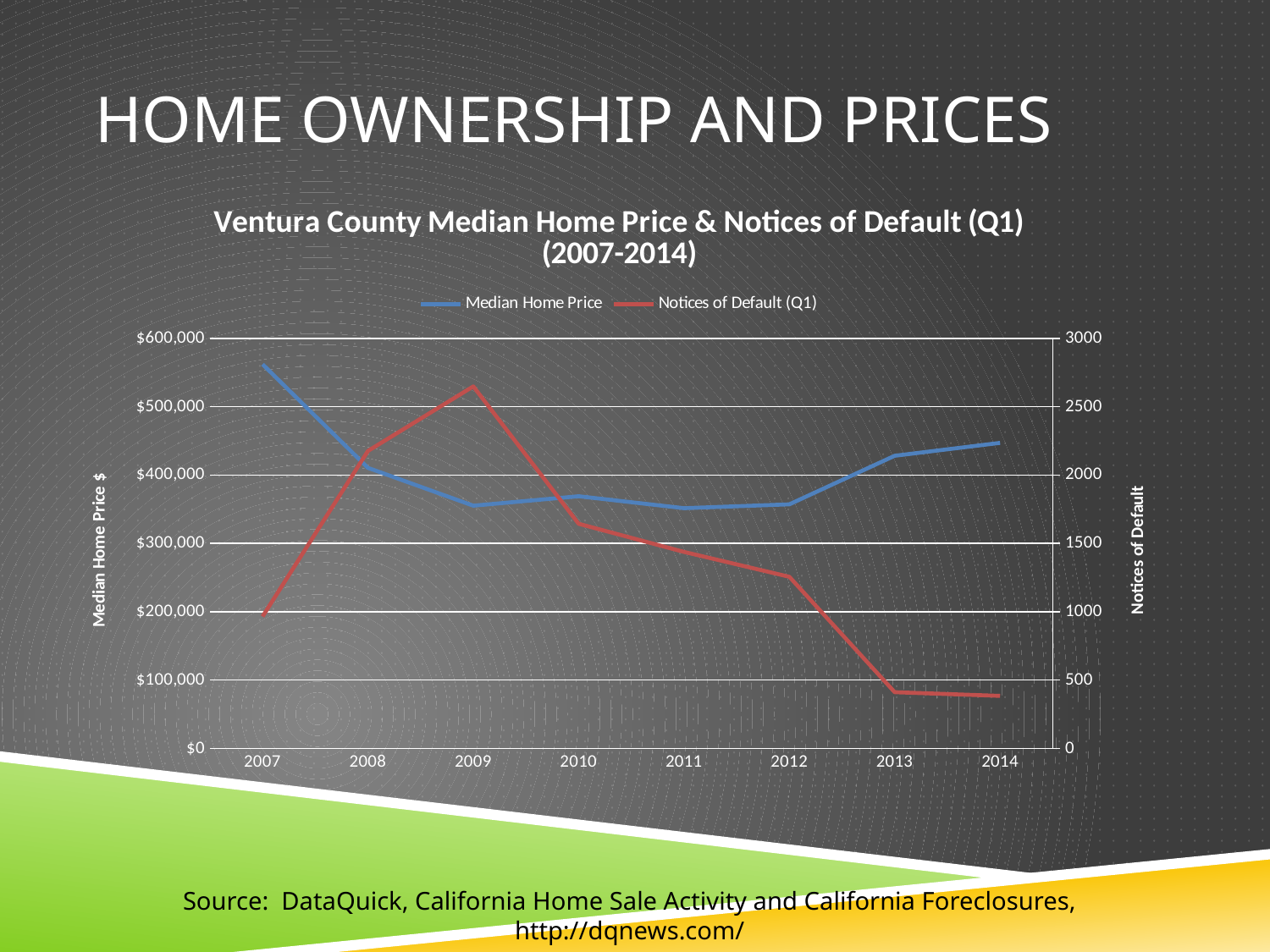
Is the Median Home Price for 2007 greater or less than $500,000? greater Is the value for Notices of Default (Q1) in 2013 greater or less than 500? less Do the Notices of Default (Q1) rise or fall from 2009 to 2014? Fall In which year is the Median Home Price highest? 2007 Which is larger, the Median Home Price in 2007 or in 2014? 2007 How many series does the legend list? 2 How many years are plotted along the x axis? 8 In which year are the Notices of Default (Q1) highest? 2009 Is the Median Home Price for 2014 greater or less than $400,000? greater What kind of chart is shown on the slide? Line chart What is the title of the chart? Ventura County Median Home Price & Notices of Default (Q1) (2007-2014)